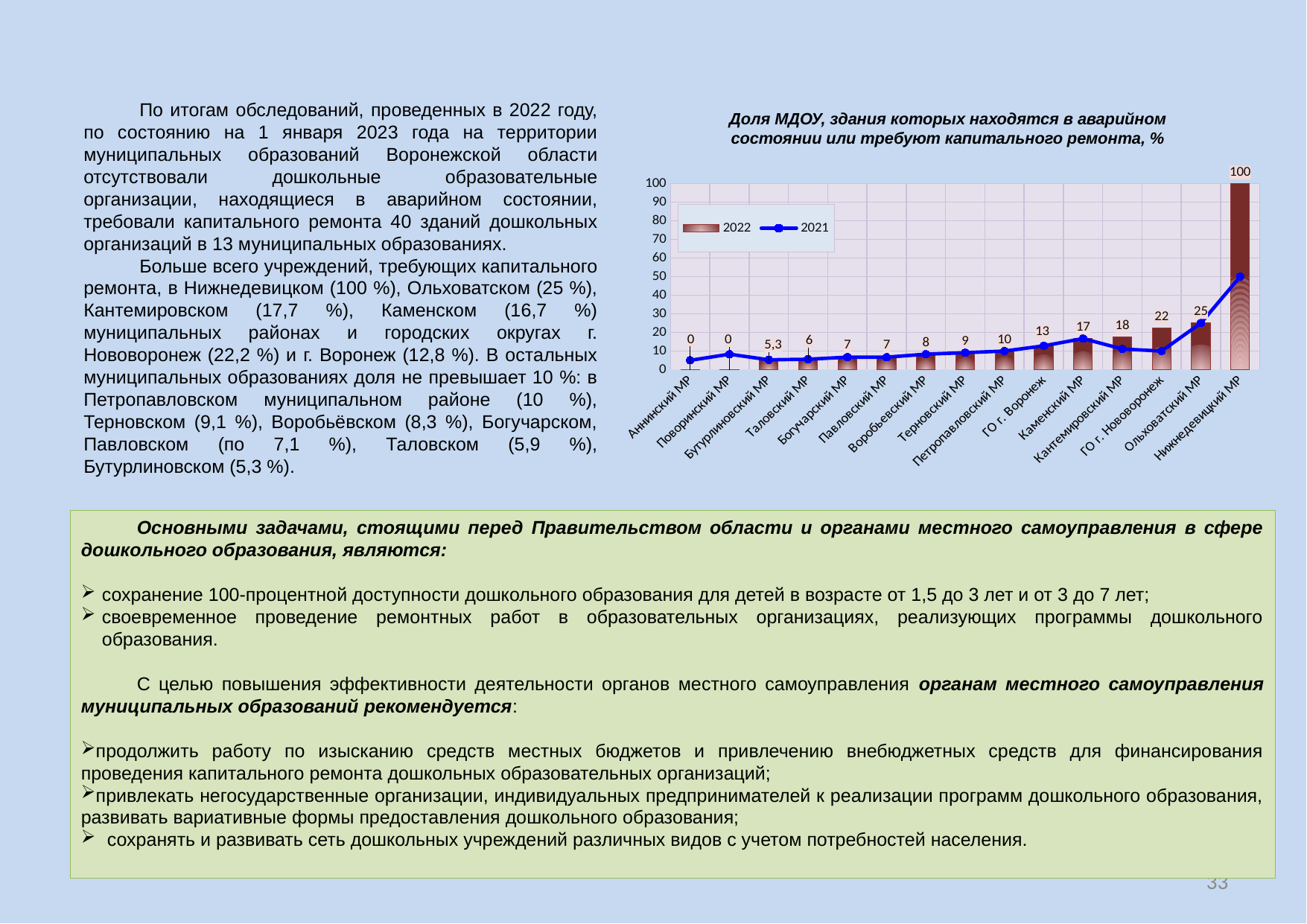
What is the 2022 value for Бутурлиновский МР? 5,3 How many series does the legend list? 2 Which has a larger 2022 value, Каменский МР or ГО г. Нововоронеж? ГО г. Нововоронеж What is the 2022 value for Ольховатский МР? 25 What is the 2022 value for Кантемировский МР? 18 What is the 2022 value for ГО г. Воронеж? 13 Which category has the highest 2022 value? Нижнедевицкий МР Which series is shown as a line with markers? 2021 What is the difference between the 2022 values for Нижнедевицкий МР and Ольховатский МР? 75 Is the 2021 value for Нижнедевицкий МР greater or less than 40? greater How many categories are shown on the x axis? 15 Do the 2022 values rise or fall from left to right along the x axis? rise